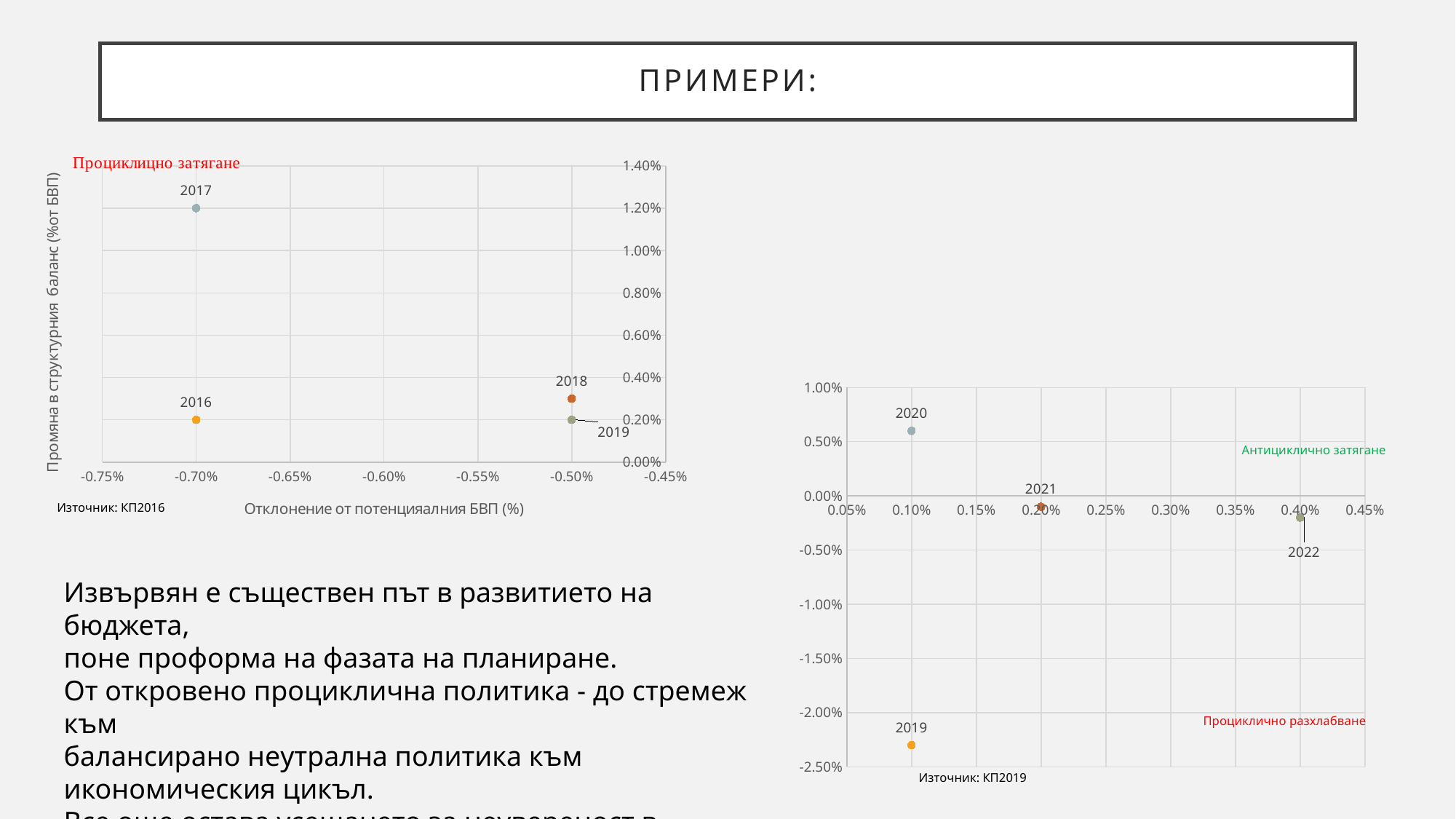
On the left chart (source КП2016), what is the x-axis value for 2018? -0.50% What kind of chart is the left chart (source КП2016)? scatter chart On the left chart (source КП2016), which has the higher vertical-axis value, 2017 or 2018? 2017 On the left chart (source КП2016), what is the deviation from potential GDP (x-axis value) for 2017? -0.70% How many data points are plotted on the right chart (source КП2019)? 4 On the left chart (source КП2016), is the vertical-axis value for 2017 greater or less than 1.00%? greater On the right chart (source КП2019), what is the x-axis value for 2021? 0.20% On the left chart (source КП2016), which year has the highest change in structural balance? 2017 On the right chart (source КП2019), is the vertical-axis value for 2019 greater or less than -2.00%? less What is the x-axis title of the left chart (source КП2016)? Отклонение от потенциялния БВП (%) On the right chart (source КП2019), which has the higher vertical-axis value, 2020 or 2022? 2020 On the right chart (source КП2019), which year has the lowest value on the vertical axis? 2019